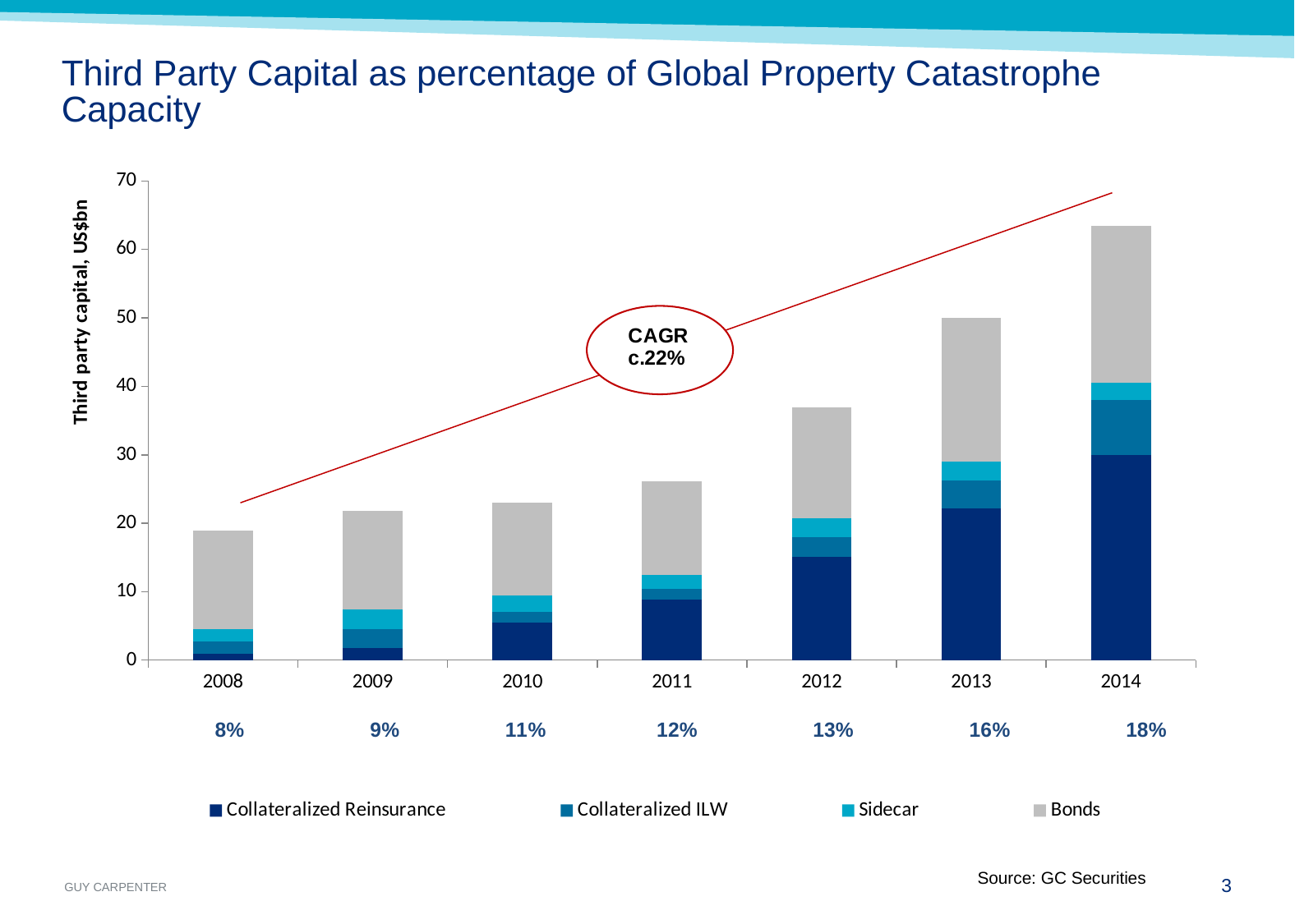
Do the total bar heights rise or fall from 2008 to 2014? rise What percentage is printed below the 2014 bar? 18% Is the total third party capital for 2008 greater or less than 20? less What kind of chart is shown on the slide? stacked bar chart Which year has the shortest stacked bar? 2008 How many years are shown along the x axis of the chart? 7 Is the total third party capital for 2012 greater or less than 30? greater Which year has the tallest stacked bar? 2014 Which year has the larger total bar, 2012 or 2013? 2013 Is the total third party capital for 2014 greater or less than 60? greater How many series does the chart's legend list? 4 What CAGR is stated in the circled annotation on the chart? c.22%